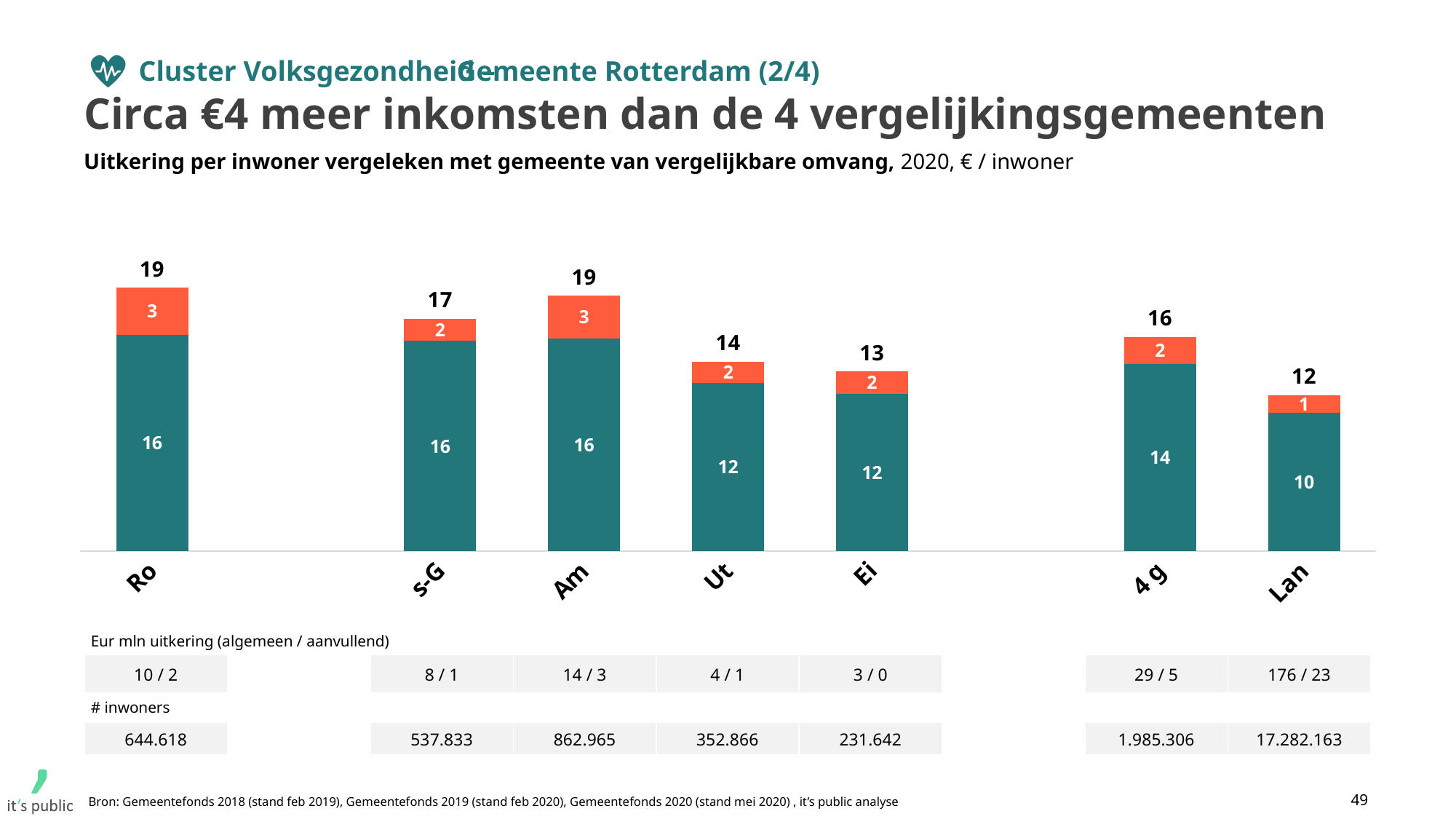
How many categories are shown on the x axis? 7 What kind of chart is shown on the slide? Stacked bar chart What is the difference between the total for Ro and the total for Ut? 5 What is the value of the teal (lower) segment of the bar for 4 g? 14 Which is larger, the total for s-G or the total for Ei? s-G What is the value of the teal (lower) segment of the bar for Lan? 10 What is the total value shown above the bar for 4 g? 16 Which category has the lowest total value? Lan What is the value of the orange (upper) segment of the bar for Am? 3 What is the total of the stacked bar for Ut, based on its segment values 12 and 2? 14 What is the total value shown above the bar for Ro? 19 What is the difference between the orange segment for Ro and the orange segment for Lan? 2